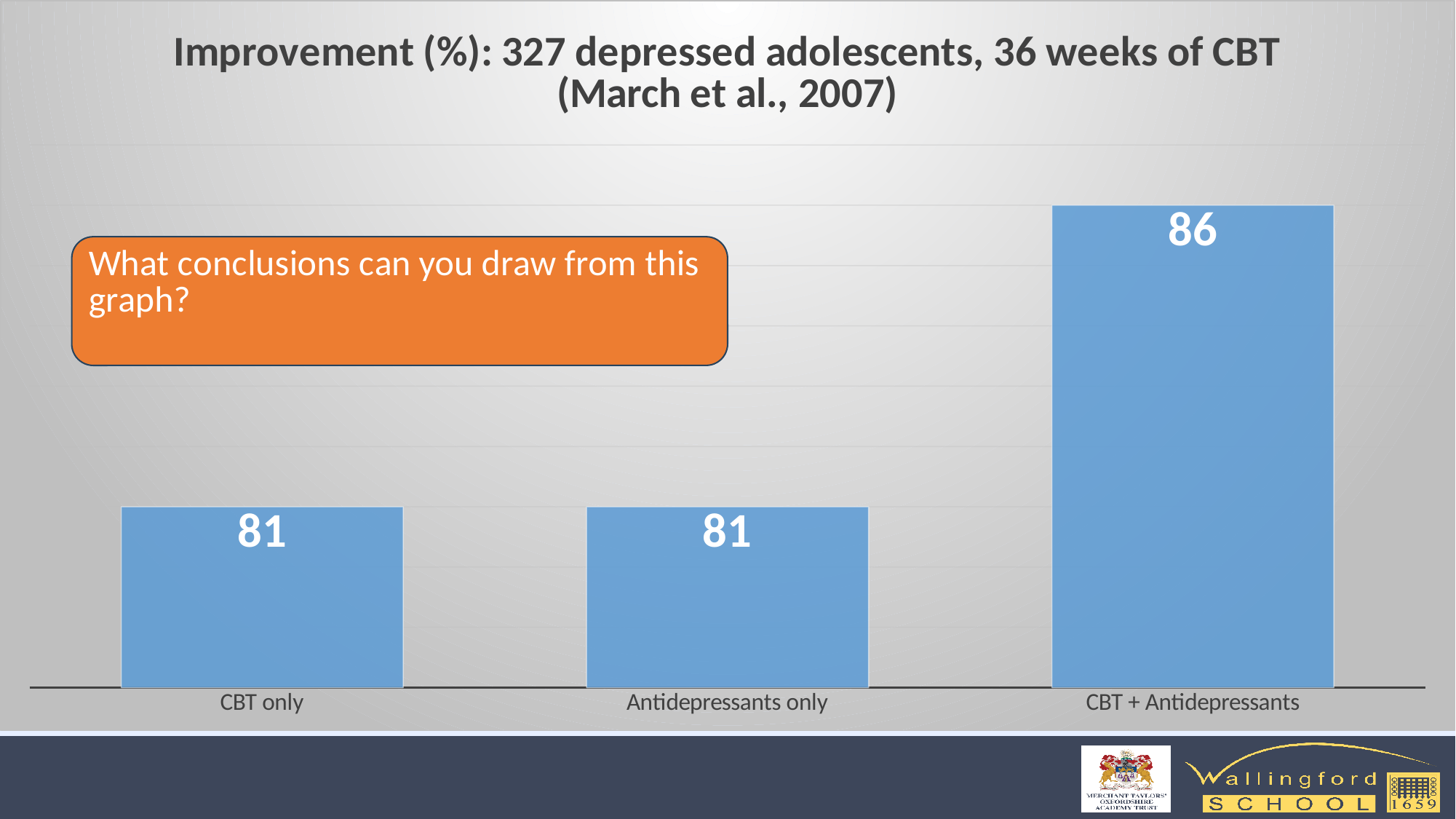
What kind of chart is shown on the slide? Bar chart What is the improvement value for CBT only? 81 Which category has the highest improvement value? CBT + Antidepressants What is the difference between the values for CBT + Antidepressants and CBT only? 5 How many categories are shown on the chart? 3 What colour are the bars in the chart? Blue What is the title of the chart? Improvement (%): 327 depressed adolescents, 36 weeks of CBT (March et al., 2007) Do CBT only and Antidepressants only have the same value? Yes What is the improvement value for Antidepressants only? 81 Which is larger, the value for CBT + Antidepressants or the value for Antidepressants only? CBT + Antidepressants What is the improvement value for CBT + Antidepressants? 86